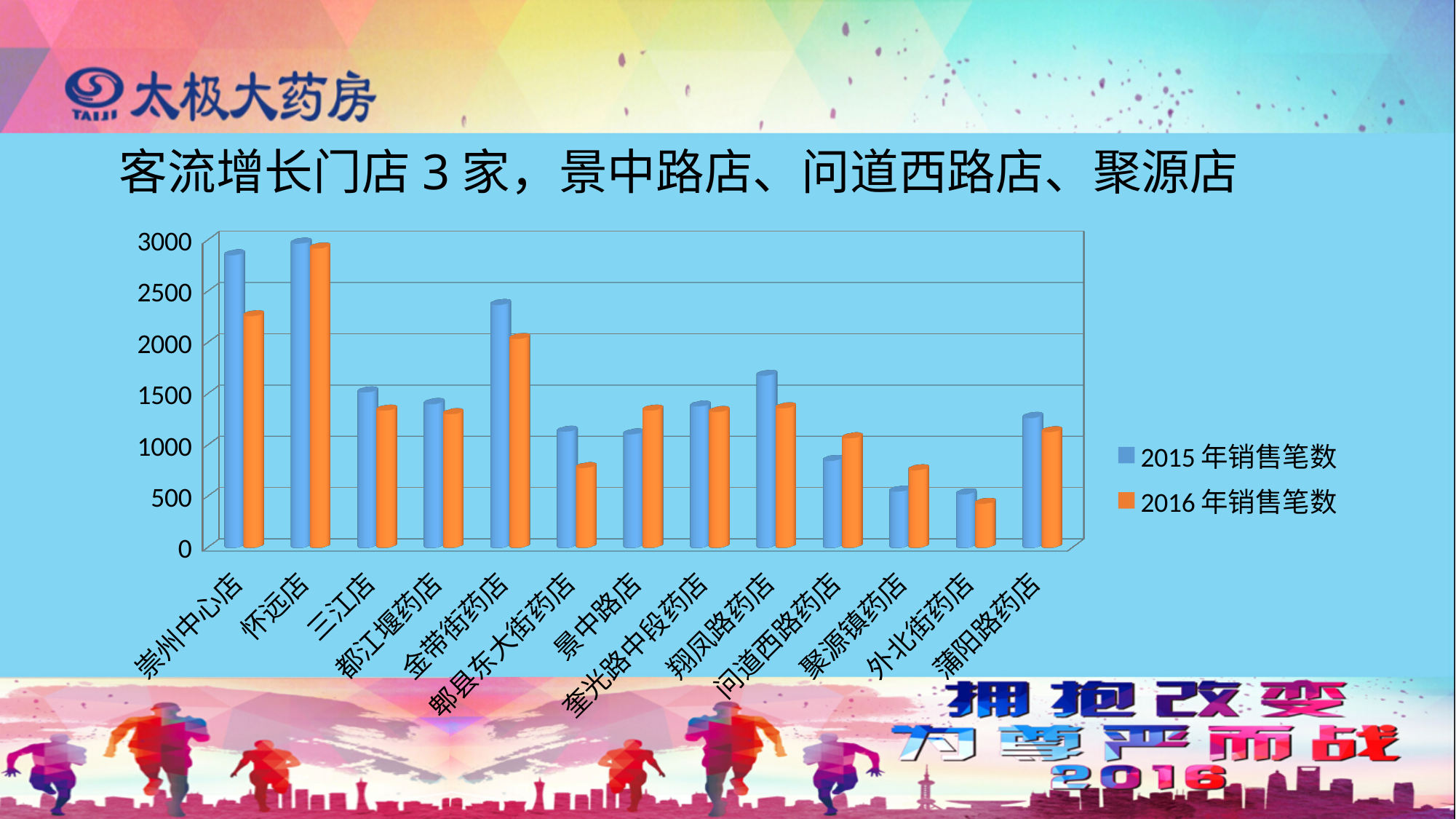
Which store has the lowest 2016年销售笔数 value? 外北街药店 How many stores (categories) are shown on the x axis of the chart? 13 For 景中路店, which is larger: the 2015年销售笔数 value or the 2016年销售笔数 value? 2016年销售笔数 How many series does the chart's legend list? 2 Which store has the highest 2015年销售笔数 value? 怀远店 Is the 2016年销售笔数 value for 崇州中心店 greater or less than 2000? greater For 崇州中心店, which is larger: the 2015年销售笔数 value or the 2016年销售笔数 value? 2015年销售笔数 Is the 2015年销售笔数 value for 聚源镇药店 greater or less than 1000? less Is the 2015年销售笔数 value for 金带街药店 greater or less than 2000? greater What kind of chart is shown on the slide? bar chart What are the two series names listed in the chart's legend? 2015年销售笔数 and 2016年销售笔数